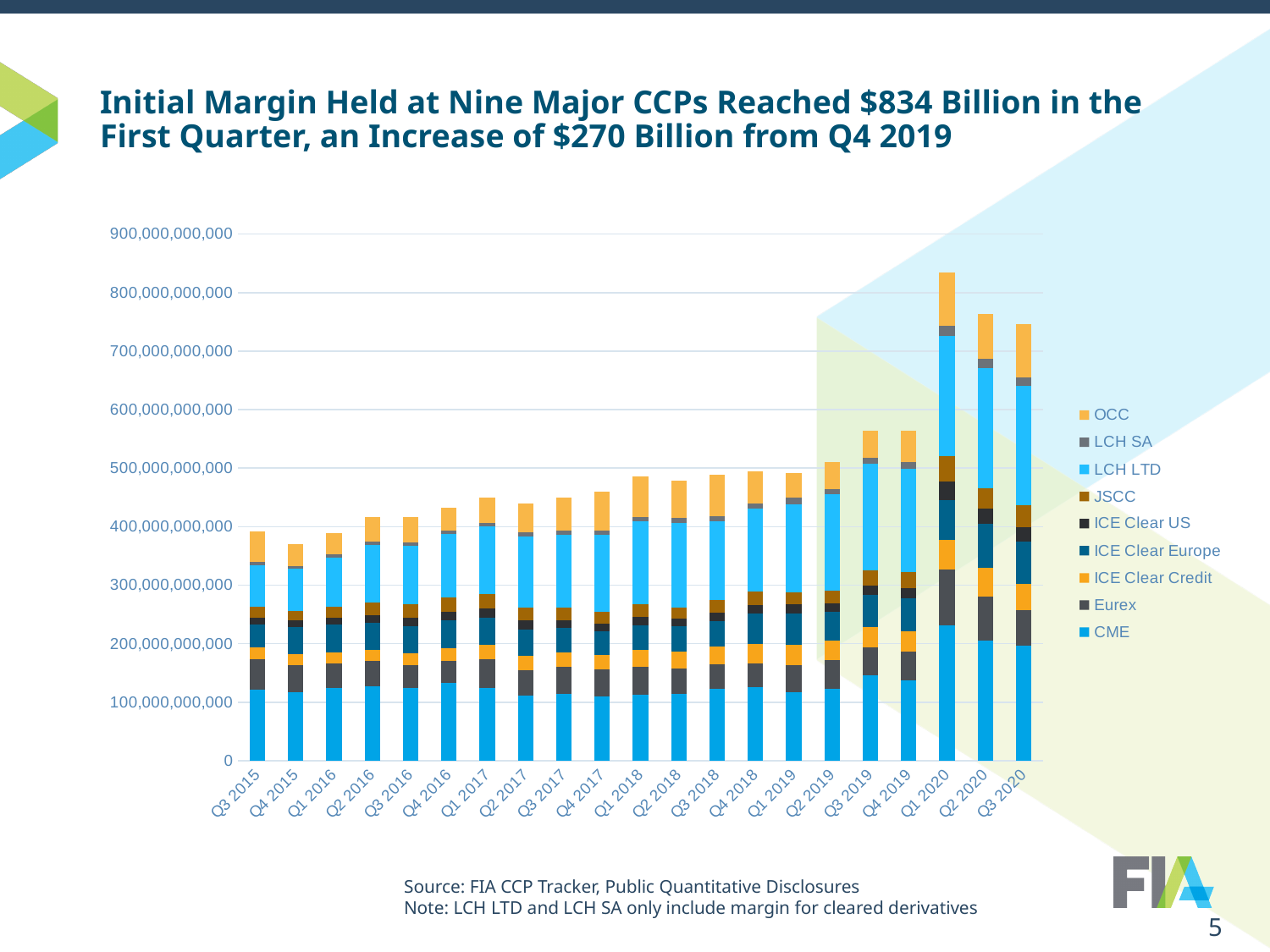
Is the total bar for Q4 2015 greater or less than 400,000,000,000? less Is the total bar for Q3 2019 greater or less than 500,000,000,000? greater Is the total bar for Q1 2020 greater or less than 800,000,000,000? greater How many series does the chart's legend list? 9 Overall, do the total bars rise or fall from Q3 2015 to Q1 2020? rise Which series is listed last (at the bottom) in the chart's legend? CME What kind of chart is shown on the slide? Stacked bar chart Which quarter has the lowest total initial margin in the chart? Q4 2015 How many quarters are plotted along the x axis of the chart? 21 Which quarter has the highest total initial margin in the chart? Q1 2020 Which quarter has a larger total bar, Q1 2020 or Q2 2020? Q1 2020